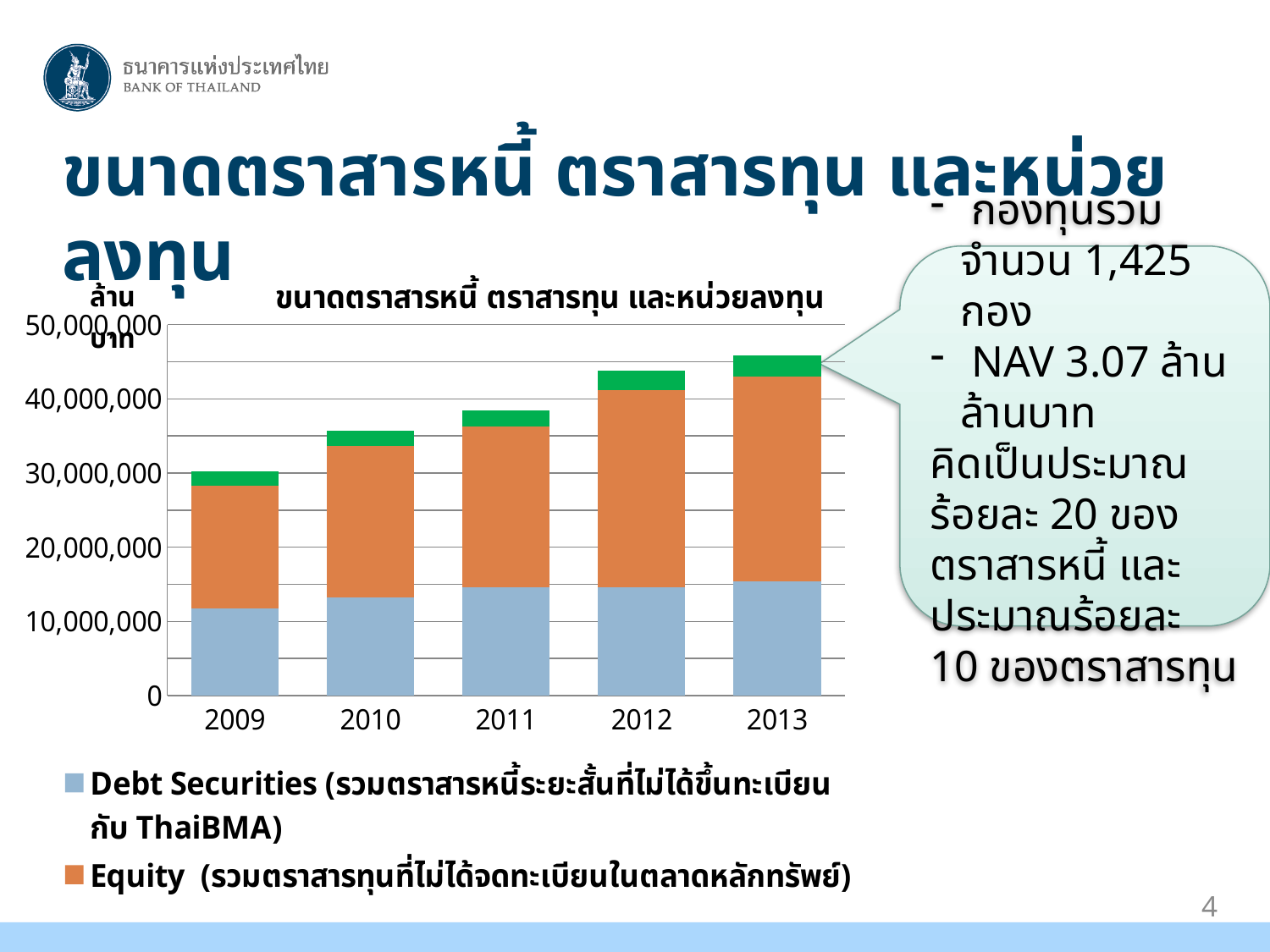
Is the Debt Securities value for 2013 greater or less than 20,000,000? less Is the total bar for 2011 greater or less than 40,000,000? less Do the total bar heights rise or fall from 2009 to 2013? Rise Is the total bar for 2013 greater or less than 40,000,000? greater Which year has the shortest total bar in the chart? 2009 What colour represents the Equity series in the chart? Orange How many years are shown on the x axis of the chart? 5 What kind of chart is shown on the slide? Stacked bar chart Which year has the tallest total bar in the chart? 2013 What is the title of the chart? ขนาดตราสารหนี้ ตราสารทุน และหน่วยลงทุน Which year has the larger total bar, 2009 or 2012? 2012